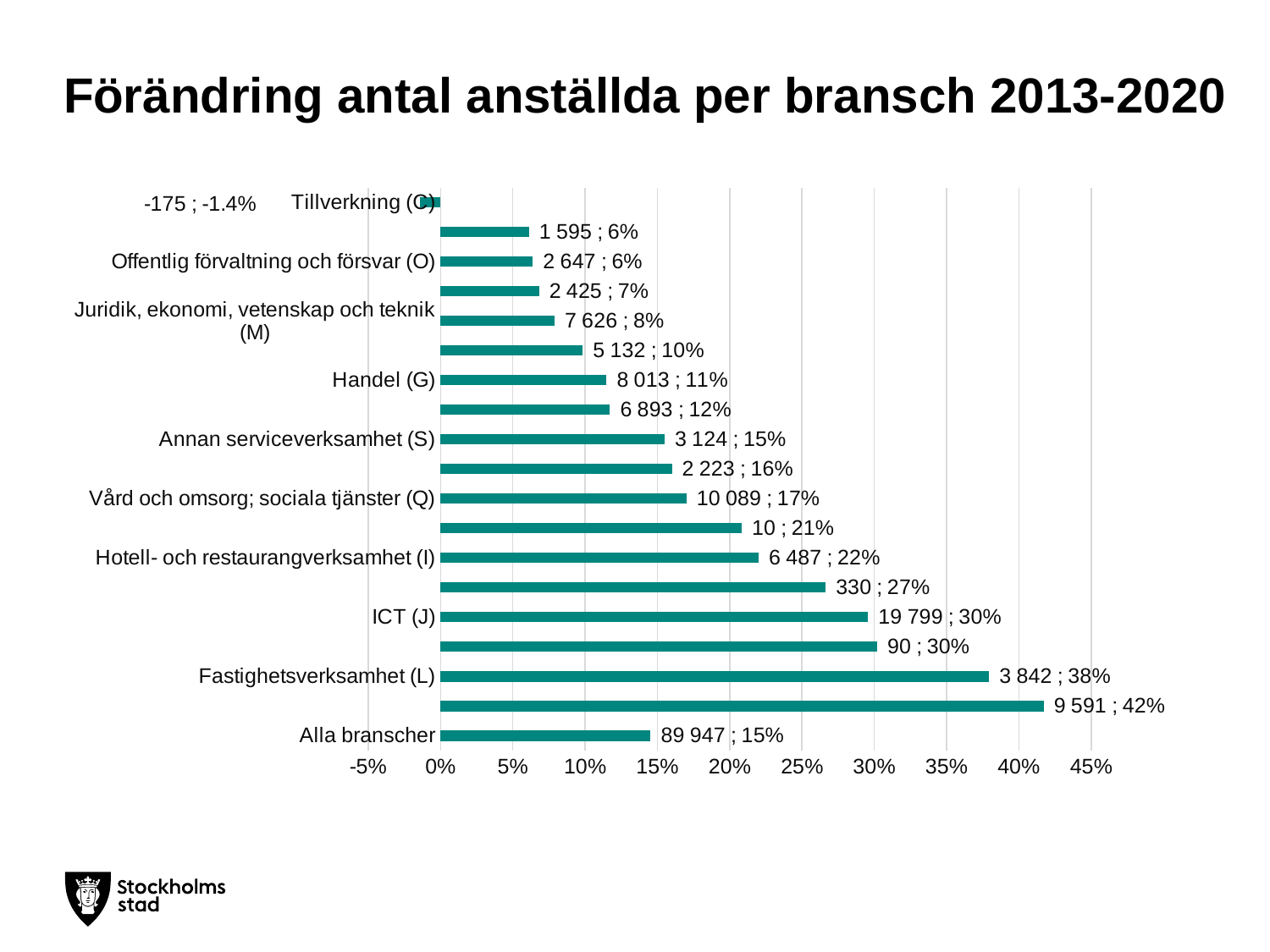
What is the data label shown for Tillverkning (C)? -175 ; -1.4% What is the title of the chart? Förändring antal anställda per bransch 2013-2020 What is the number of employees shown for Vård och omsorg; sociala tjänster (Q)? 10 089 What percentage change is shown for ICT (J)? 30% How many bars are plotted in the chart? 19 What percentage change is shown for Fastighetsverksamhet (L)? 38% What kind of chart is shown on the slide? bar chart Is the percentage change for Annan serviceverksamhet (S) greater or less than 10%? greater Which has a larger percentage change, ICT (J) or Handel (G)? ICT (J) What is the data label for Alla branscher? 89 947 ; 15% Which labelled category has the lowest percentage change? Tillverkning (C) What is the difference in percentage points between Hotell- och restaurangverksamhet (I) at 22% and Handel (G) at 11%? 11 percentage points